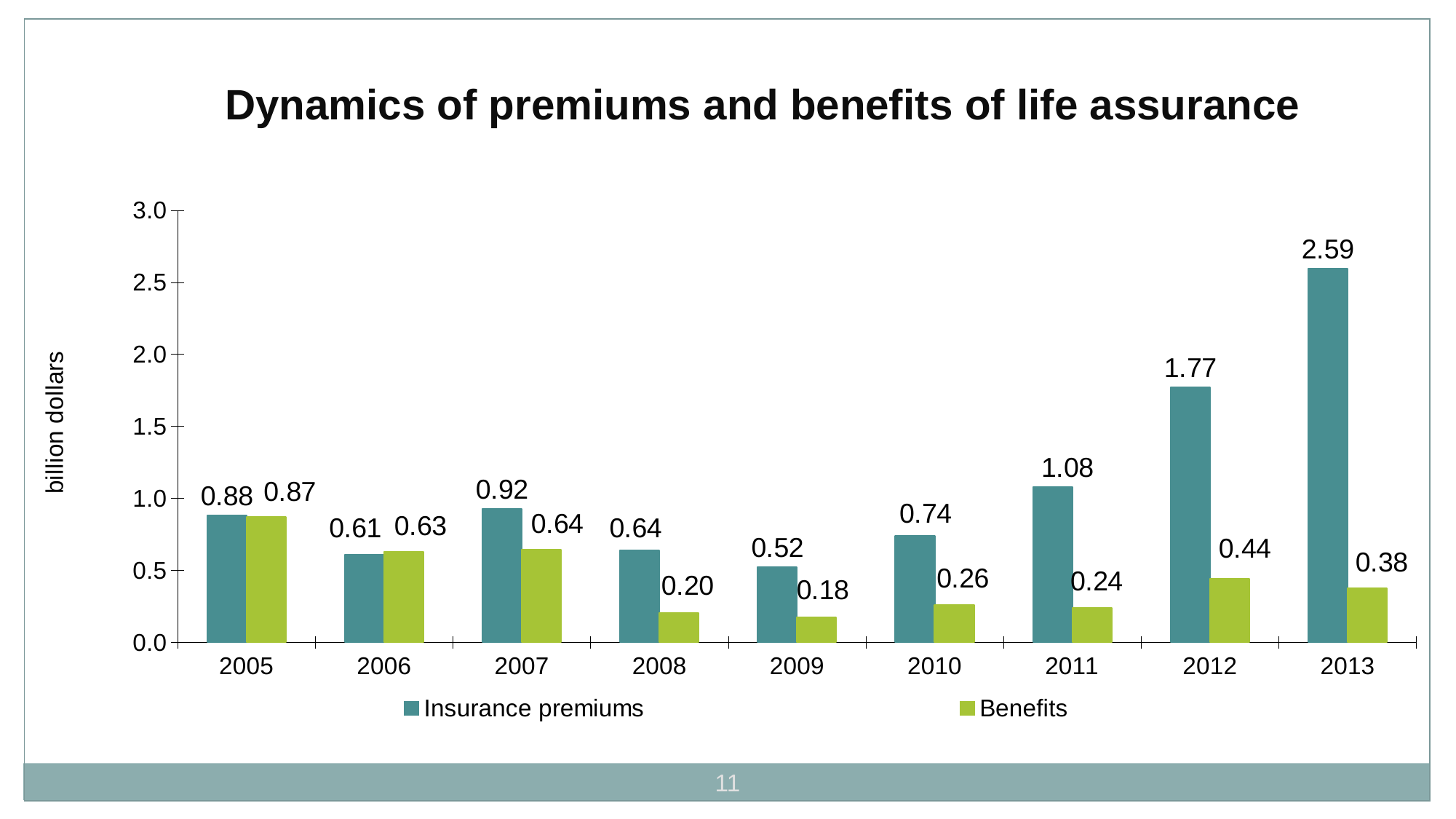
How many series does the legend list? 2 Which is larger in 2012, Insurance premiums or Benefits? Insurance premiums Is the value for Insurance premiums in 2012 greater or less than 1.5? greater Which year has the highest value for Insurance premiums? 2013 What kind of chart is shown on the slide? Bar chart What is the value of Benefits in 2009? 0.18 How many years are shown on the x axis? 9 What is the value of Insurance premiums in 2013? 2.59 Which year has the lowest value for Benefits? 2009 What is the value of Insurance premiums in 2006? 0.61 What is the label on the vertical axis? billion dollars What is the difference between Insurance premiums and Benefits in 2013? 2.21